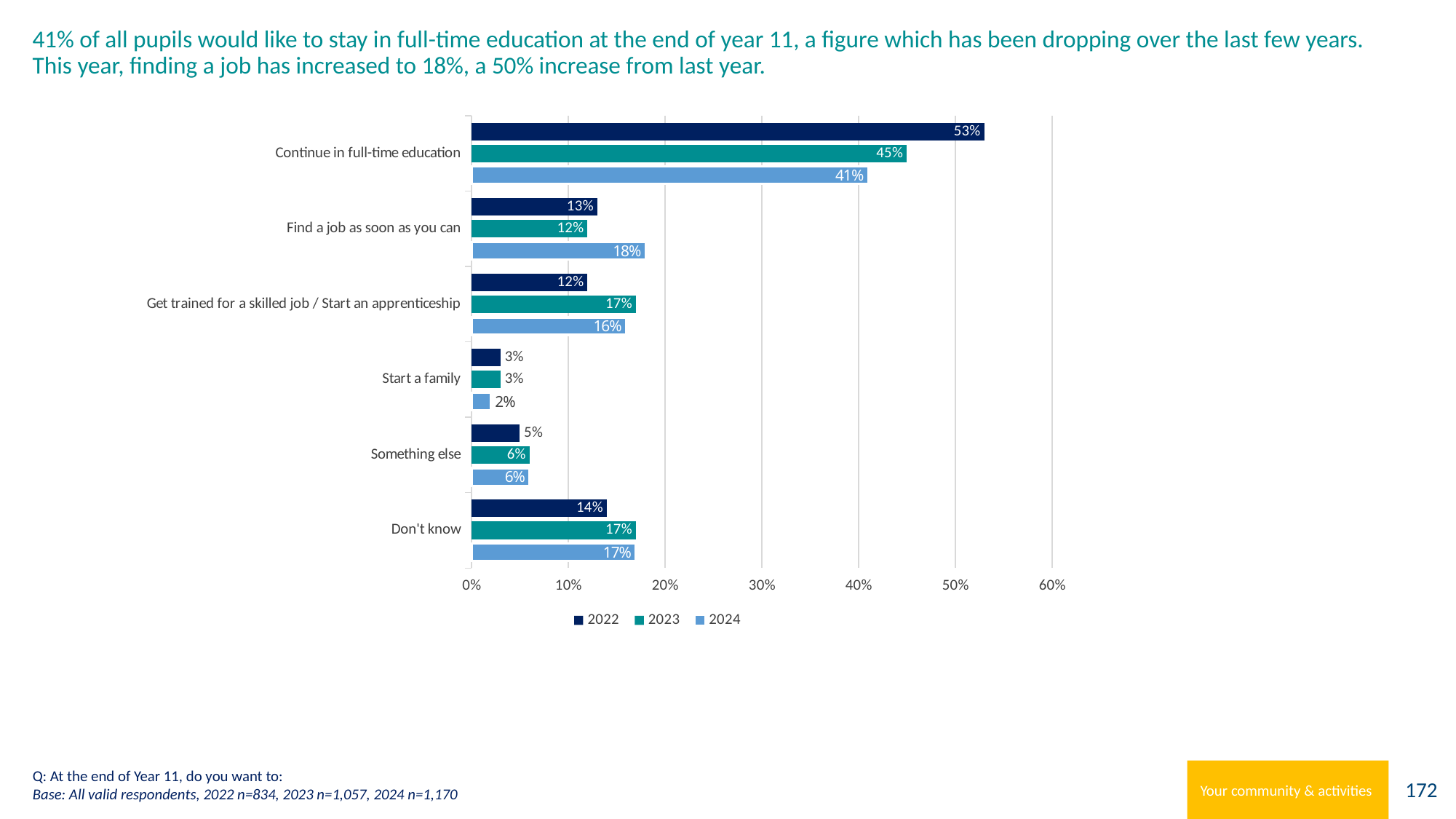
Which years are listed in the chart legend? 2022, 2023, 2024 What is the 2022 value for 'Find a job as soon as you can'? 13% What kind of chart is shown on the slide? Bar chart How many categories are shown on the chart? 6 What is the 2024 value for 'Continue in full-time education'? 41% Which category has the highest value in the 2022 series? Continue in full-time education Which category has the lowest value in the 2024 series? Start a family What is the difference between the 2023 and 2024 values for 'Find a job as soon as you can'? 6% How many series does the legend list? 3 What is the difference between the 2022 and 2024 values for 'Continue in full-time education'? 12% What is the 2023 value for 'Get trained for a skilled job / Start an apprenticeship'? 17% Which is larger for 'Don't know': the 2022 value or the 2023 value? 2023